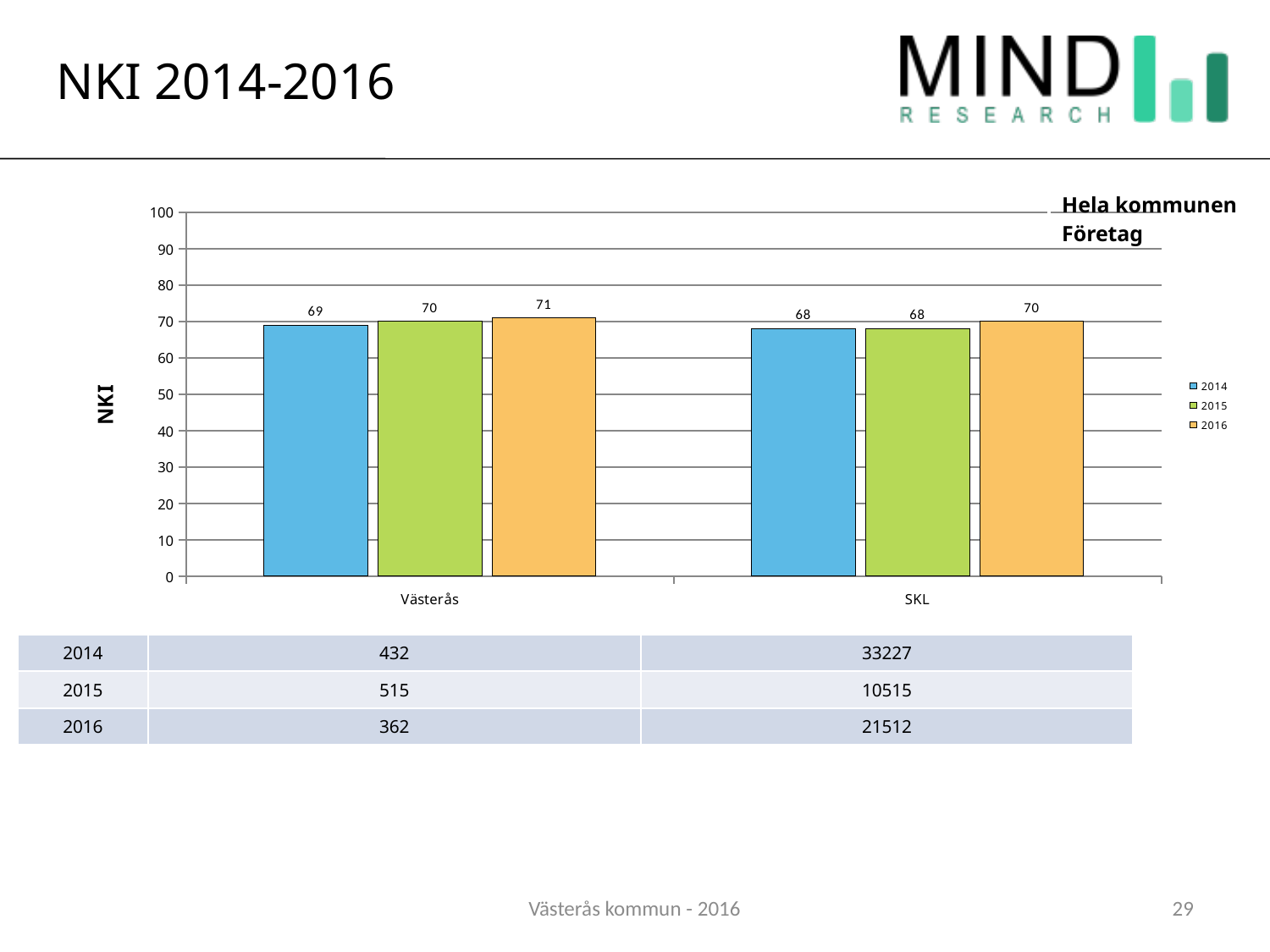
How many categories are shown on the x axis? 2 What is the NKI value for SKL in 2015? 68 What is the difference between the 2014 and 2016 NKI values for Västerås? 2 Which is larger, the 2015 NKI value for Västerås or for SKL? Västerås What kind of chart is shown on the slide? Bar chart Do the NKI values for Västerås rise or fall from 2014 to 2016? Rise What is the difference between the 2016 NKI values for Västerås and SKL? 1 What is the NKI value for Västerås in 2016? 71 How many series does the legend list? 3 Which year has the highest NKI value for Västerås? 2016 What is the NKI value for SKL in 2016? 70 What is the NKI value for Västerås in 2014? 69